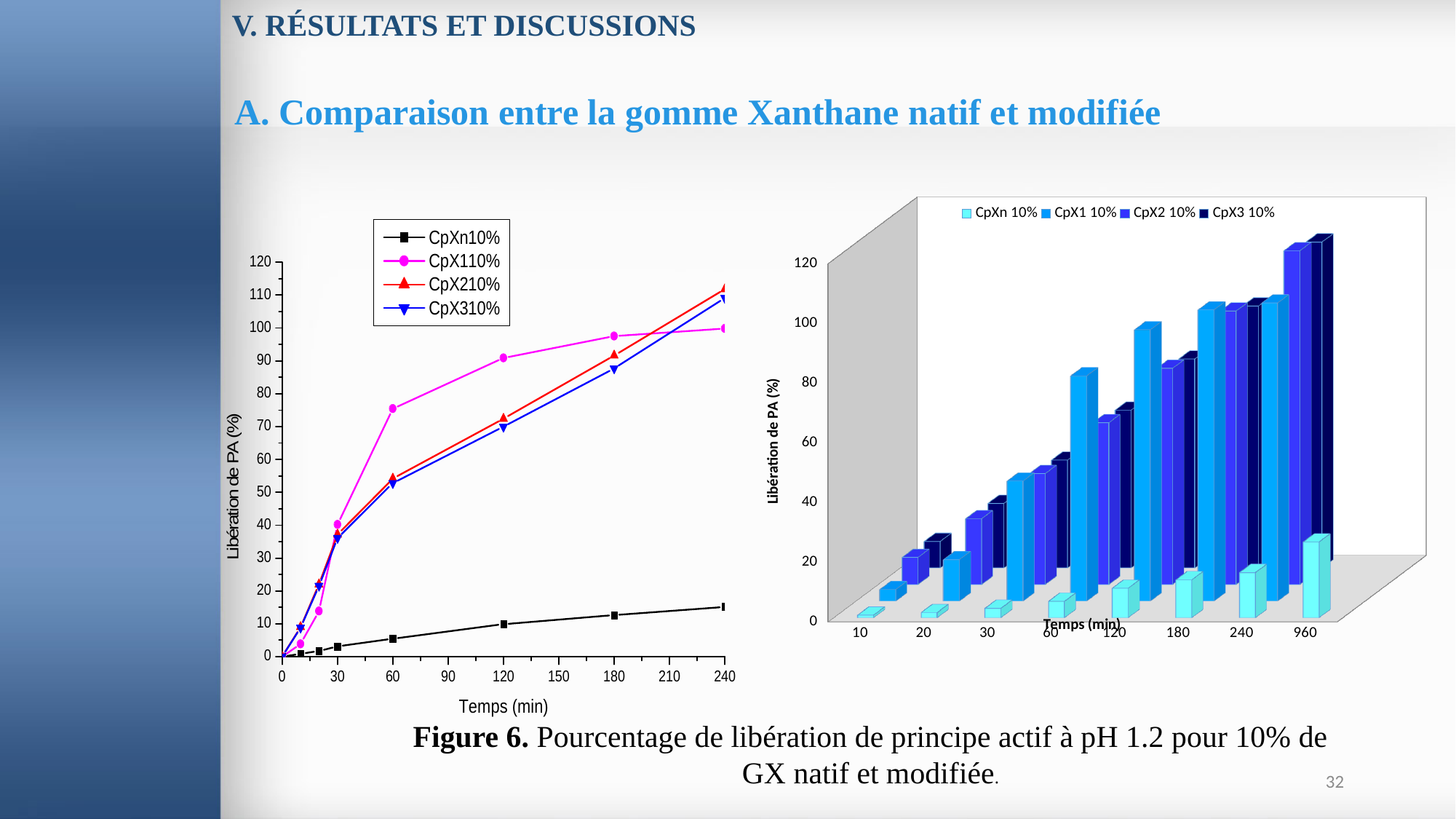
In the left chart, is the value for CpX110% at 60 min greater or less than 70? greater What kind of chart is the chart on the left of the slide? line chart How many time categories are shown on the x axis of the right chart? 8 In the right chart, do the values for CpXn 10% rise or fall as time increases along the x axis? rise In the left chart, is the value for CpXn10% at 240 min greater or less than 20? less How many series does the legend of the right chart list? 4 How many series does the legend of the left chart list? 4 What kind of chart is the chart on the right of the slide? bar chart In the left chart, which series has the lowest values across the whole time range? CpXn10% In the left chart, at 60 min, which is larger: CpX110% or CpXn10%? CpX110% In the right chart, is the value for CpXn 10% at 960 min greater or less than 40? less